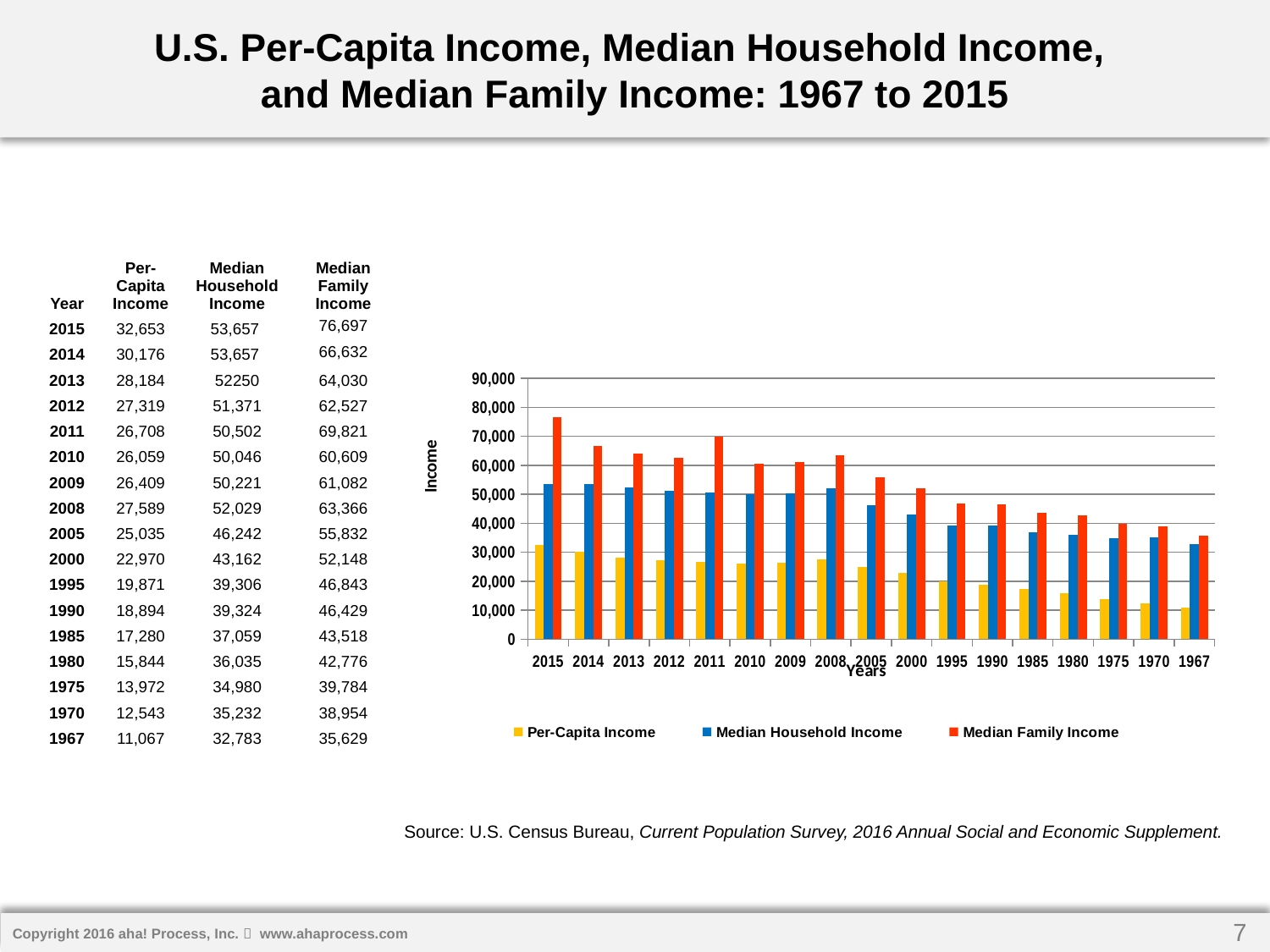
In which year is Per-Capita Income lowest? 1967 Is the Median Family Income value for 2011 greater or less than 60,000? greater What is the difference between Median Family Income and Median Household Income in 2015? 23,040 What is the Median Family Income value for 2015? 76,697 What is the Per-Capita Income value for 1967? 11,067 How many years are plotted along the x axis of the chart? 17 Which colour represents Per-Capita Income in the chart? yellow What kind of chart is shown on the slide? bar chart In which year is Median Family Income highest? 2015 Which is larger: Median Household Income in 2015 or Median Family Income in 1967? Median Household Income in 2015 How many series does the chart's legend list? 3 What is the Median Household Income value for 2000? 43,162